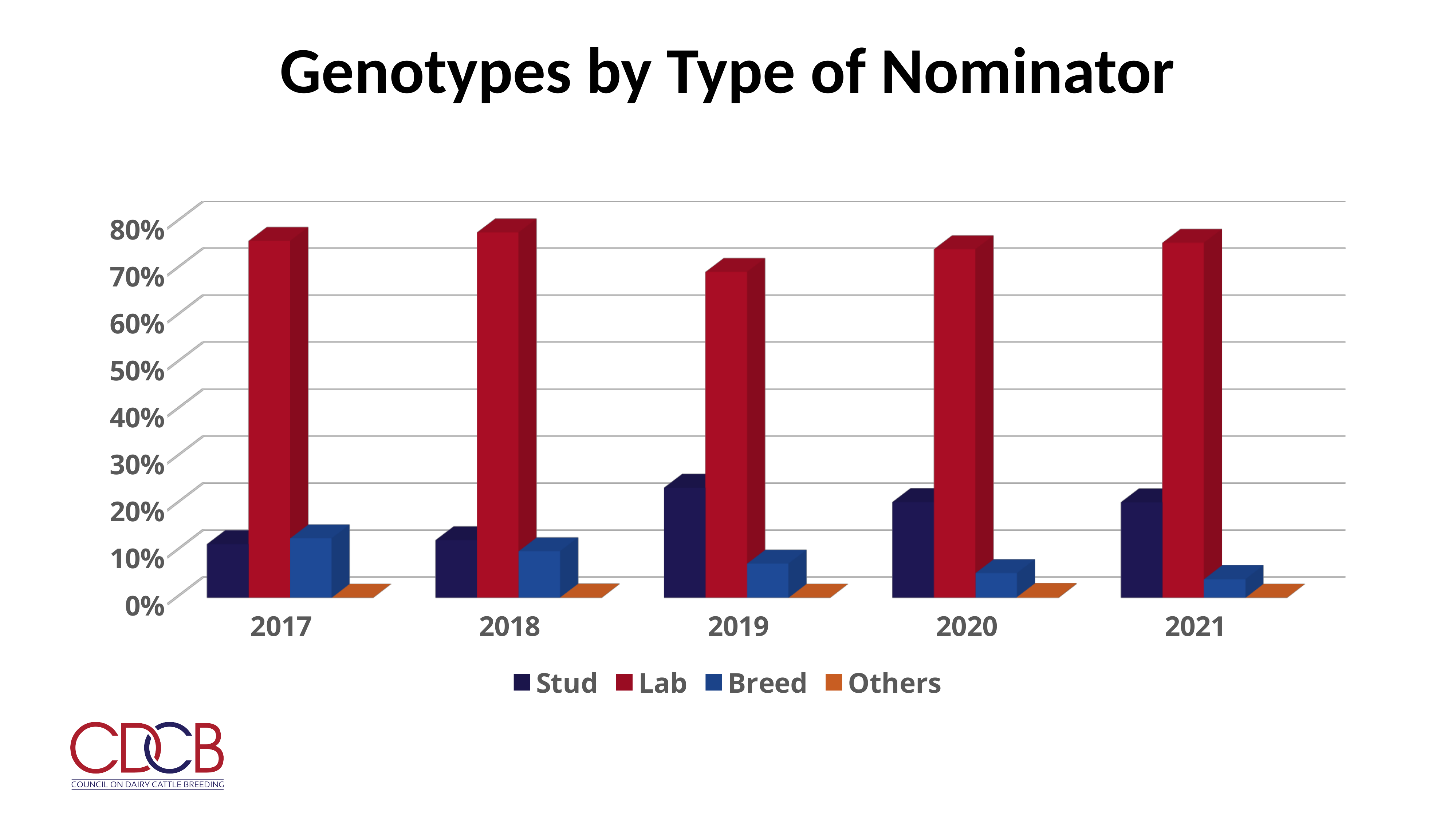
In which year is the Breed value highest? 2017 Is the Breed value for 2021 greater or less than 10%? less In which year is the Stud value highest? 2019 Which series has the highest value in every year shown? Lab Is the Stud value for 2019 greater or less than 20%? greater Does the Breed value rise or fall from 2017 to 2021? fall In which year is the Lab value lowest? 2019 Is the Lab value for 2017 greater or less than 70%? greater How many years are shown on the x axis of the chart? 5 What kind of chart is shown on the slide? bar chart How many series does the legend list? 4 In 2019, which is larger, the Stud value or the Breed value? Stud